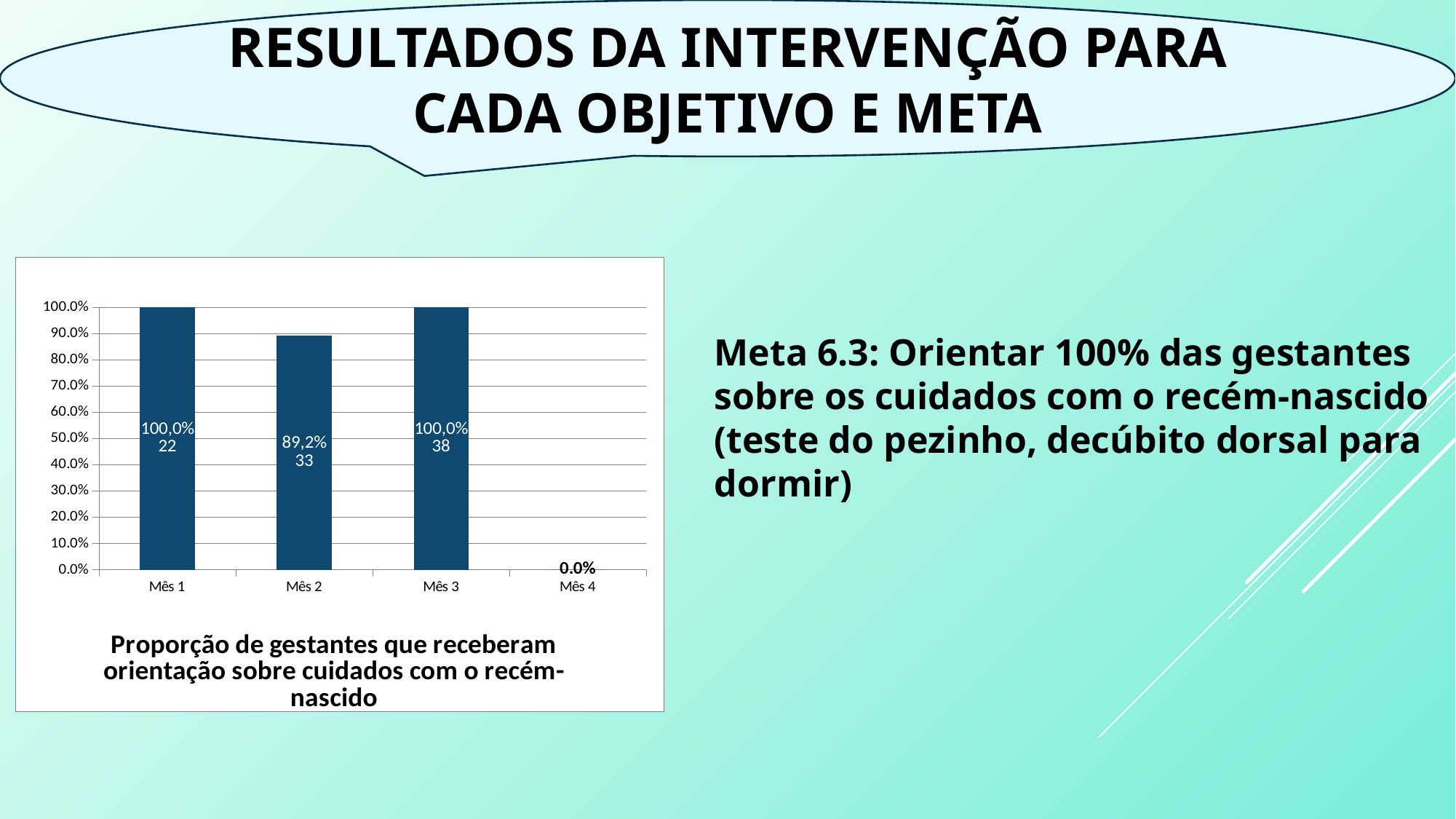
What is the value for Mês 4? 0.0% Is the value for Mês 2 greater or less than 80.0%? greater What count is printed on the bar for Mês 3? 38 What is the value for Mês 1? 100,0% What count is printed on the bar for Mês 2? 33 Which month has the lowest value? Mês 4 What kind of chart is shown? bar chart Which is larger, the value for Mês 2 or the value for Mês 3? Mês 3 What is the value for Mês 2? 89,2% What is the title of the chart? Proporção de gestantes que receberam orientação sobre cuidados com o recém-nascido What is the difference between the values for Mês 1 and Mês 2? 10,8% How many months are shown on the x axis? 4